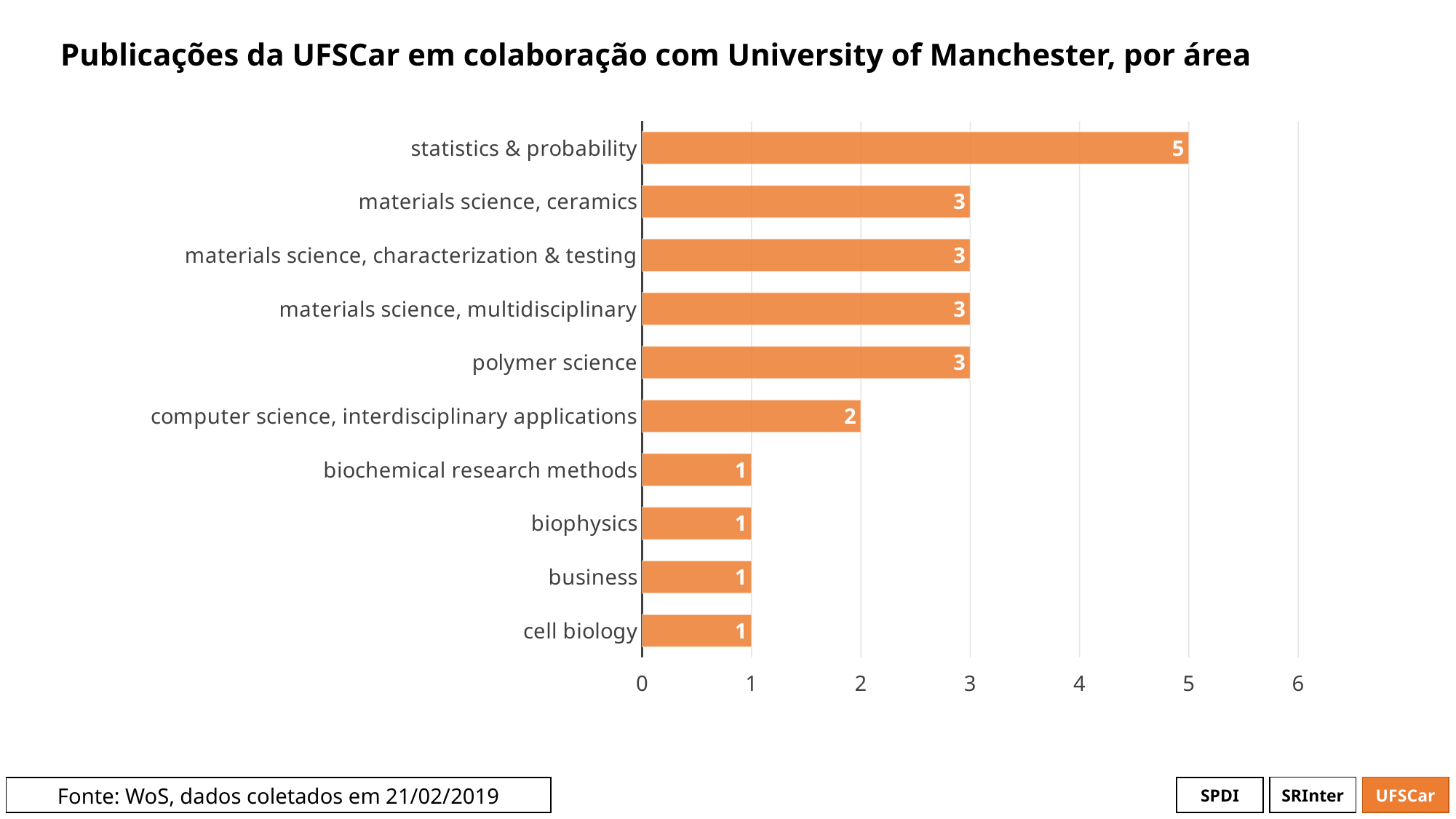
What kind of chart is shown on the slide? bar chart What is the value for cell biology? 1 What is the title of the chart? Publicações da UFSCar em colaboração com University of Manchester, por área Is the value for statistics & probability greater or less than 4? greater What is the difference between the values for statistics & probability and materials science, ceramics? 2 How many categories are shown in the chart? 10 Which is larger, the value for materials science, multidisciplinary or the value for business? materials science, multidisciplinary What is the value for statistics & probability? 5 What is the difference between the values for computer science, interdisciplinary applications and biophysics? 1 What is the value for computer science, interdisciplinary applications? 2 Which category has the highest value? statistics & probability What is the value for polymer science? 3